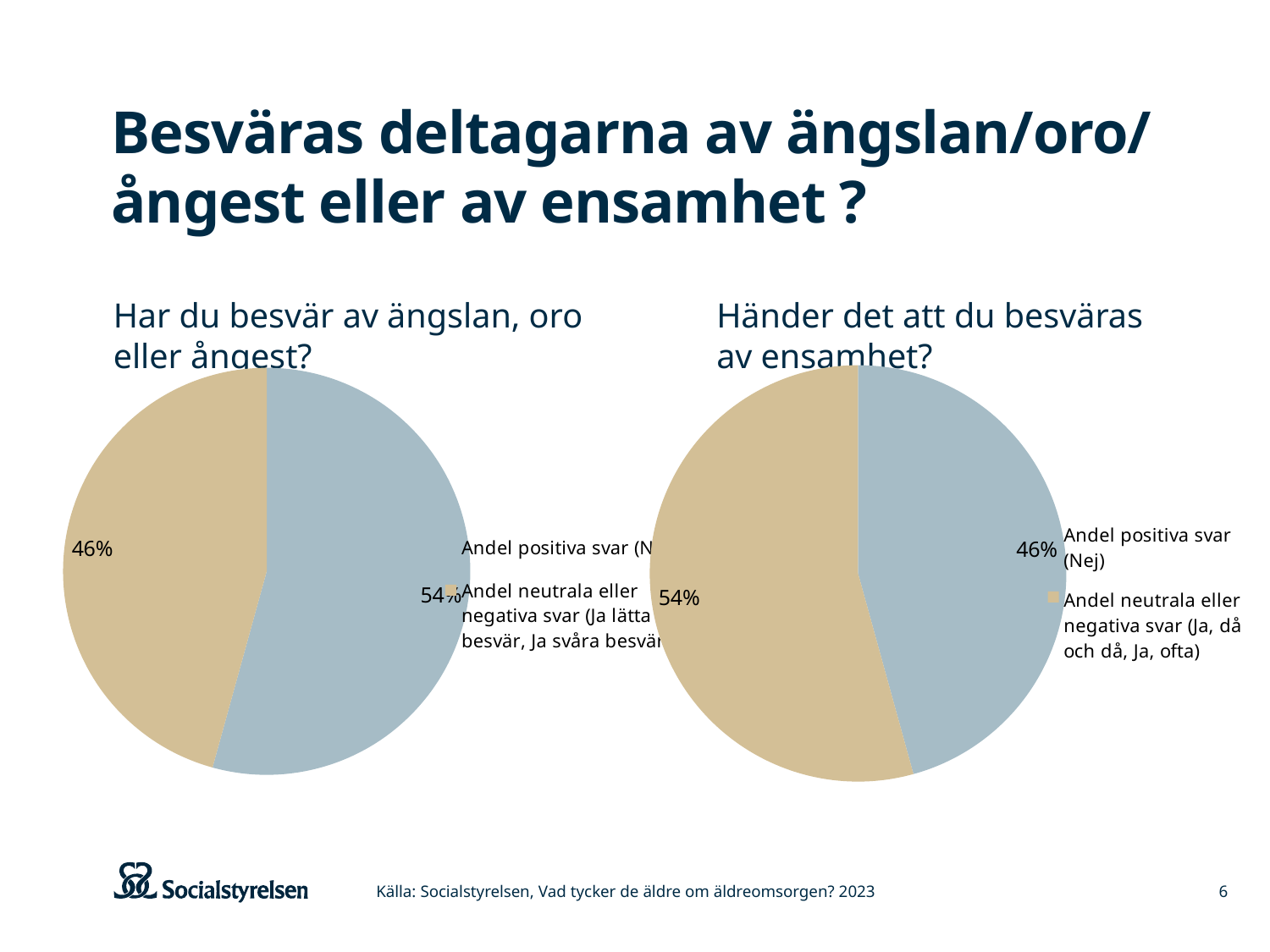
How many entries does the legend of the chart titled "Händer det att du besväras av ensamhet?" list? 2 In the chart titled "Händer det att du besväras av ensamhet?", which slice is the smallest? Andel positiva svar (Nej) What kind of charts are shown on the slide? Pie charts In the chart titled "Händer det att du besväras av ensamhet?", what is the value for Andel neutrala eller negativa svar (Ja, då och då, Ja, ofta)? 54% In the chart titled "Händer det att du besväras av ensamhet?", what is the value for Andel positiva svar (Nej)? 46% In the chart titled "Händer det att du besväras av ensamhet?", which slice is the largest? Andel neutrala eller negativa svar (Ja, då och då, Ja, ofta) In the chart titled "Händer det att du besväras av ensamhet?", is the slice for Andel positiva svar (Nej) larger or smaller than the slice for Andel neutrala eller negativa svar? Smaller In the chart titled "Har du besvär av ängslan, oro eller ångest?", what is the difference between the 54% slice and the 46% slice? 8 percentage points In the chart titled "Händer det att du besväras av ensamhet?", what colour is the slice for Andel positiva svar (Nej)? Blue-grey In the chart titled "Händer det att du besväras av ensamhet?", what is the difference between the two slices? 8 percentage points How many slices does the chart titled "Händer det att du besväras av ensamhet?" have? 2 In the chart titled "Har du besvär av ängslan, oro eller ångest?", what share of the pie is labelled 46%? Andel neutrala eller negativa svar